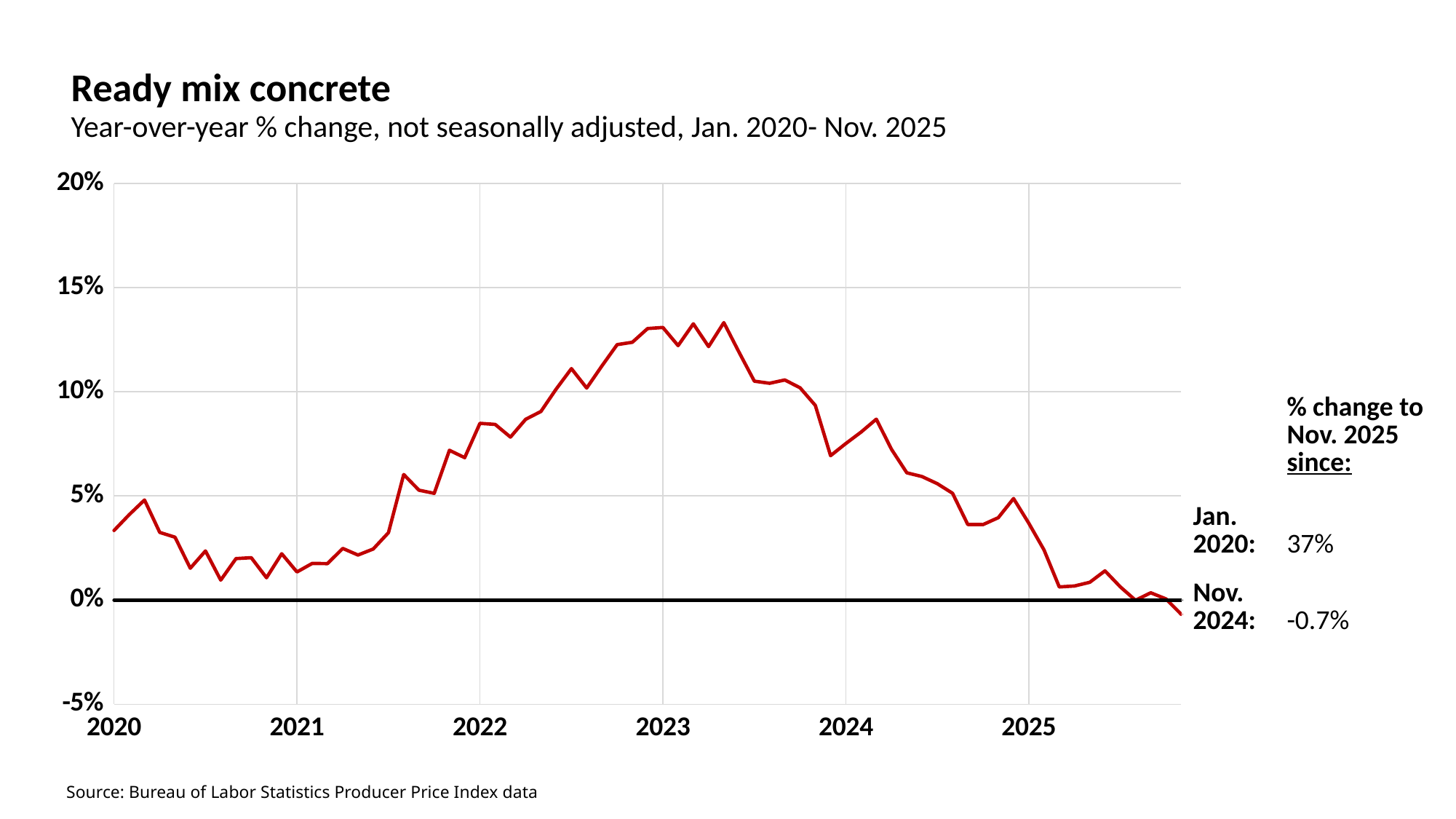
Is the peak year-over-year % change, reached around early 2023, greater or less than 15%? less Does the year-over-year % change generally rise or fall between the start of 2023 and the end of 2025? fall Is the peak year-over-year % change, reached around early 2023, greater or less than 10%? greater According to the annotation, what is the % change to Nov. 2025 since Nov. 2024? -0.7% Which is larger: the year-over-year % change at the start of 2023 or at the start of 2025? start of 2023 According to the annotation, what is the % change to Nov. 2025 since Jan. 2020? 37% What kind of chart is shown on the slide? line chart Is the year-over-year % change at the start of 2020 greater or less than 5%? less Does the year-over-year % change generally rise or fall between the start of 2021 and the start of 2023? rise What is the title of the chart? Ready mix concrete